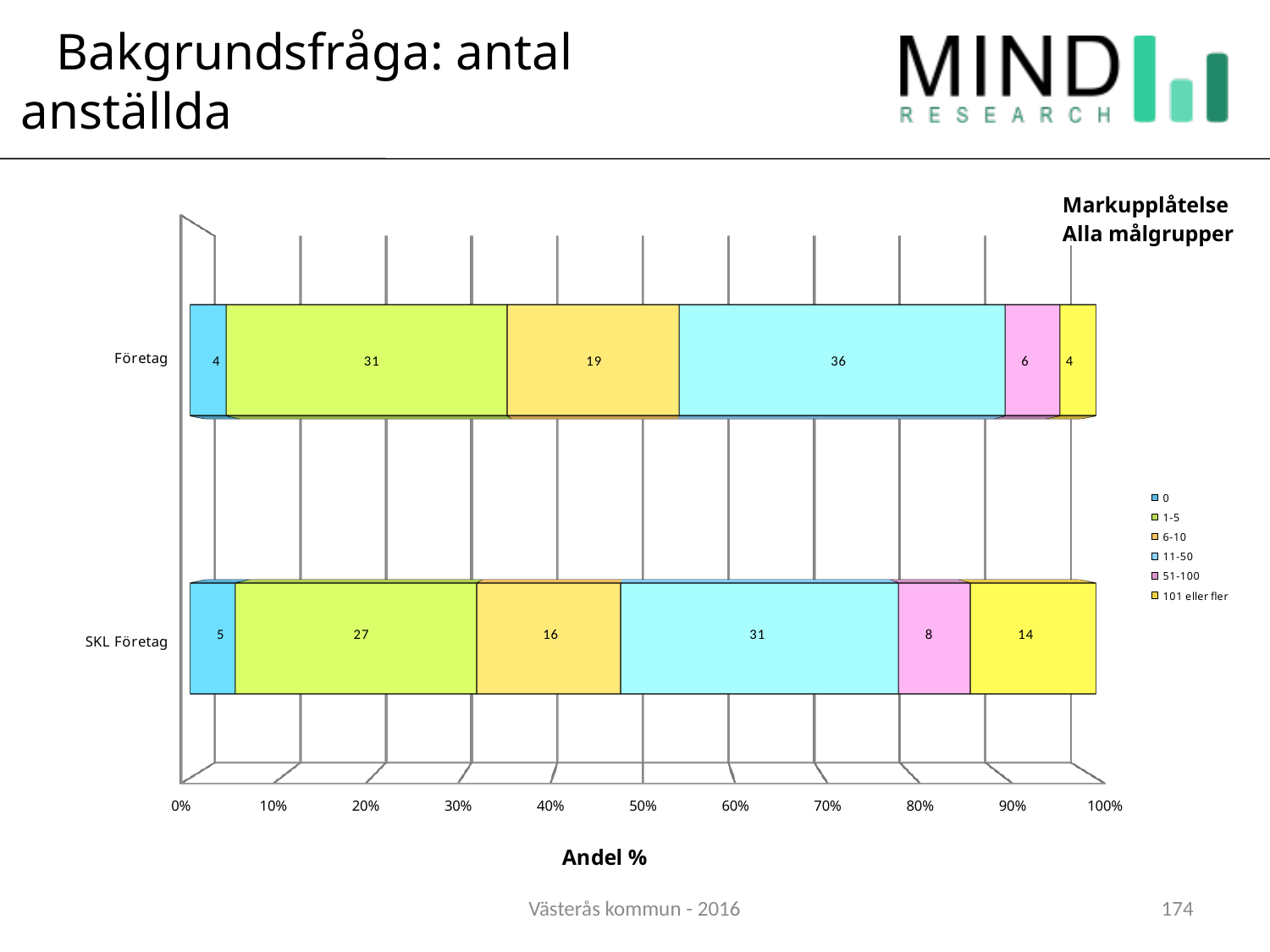
What is the total of the SKL Företag bar? 101 What is the value of the 11-50 segment for Företag? 36 Which segment is the smallest in the SKL Företag bar? 0 How many series does the legend list? 6 Which segment is the largest in the Företag bar? 11-50 Which has a larger 101 eller fler value, Företag or SKL Företag? SKL Företag What is the difference between the 1-5 values for Företag and SKL Företag? 4 What is the value of the 1-5 segment for SKL Företag? 27 What is the value of the 101 eller fler segment for SKL Företag? 14 What kind of chart is shown on the slide? Stacked bar chart What is the value of the 6-10 segment for Företag? 19 How many categories are shown on the y axis? 2